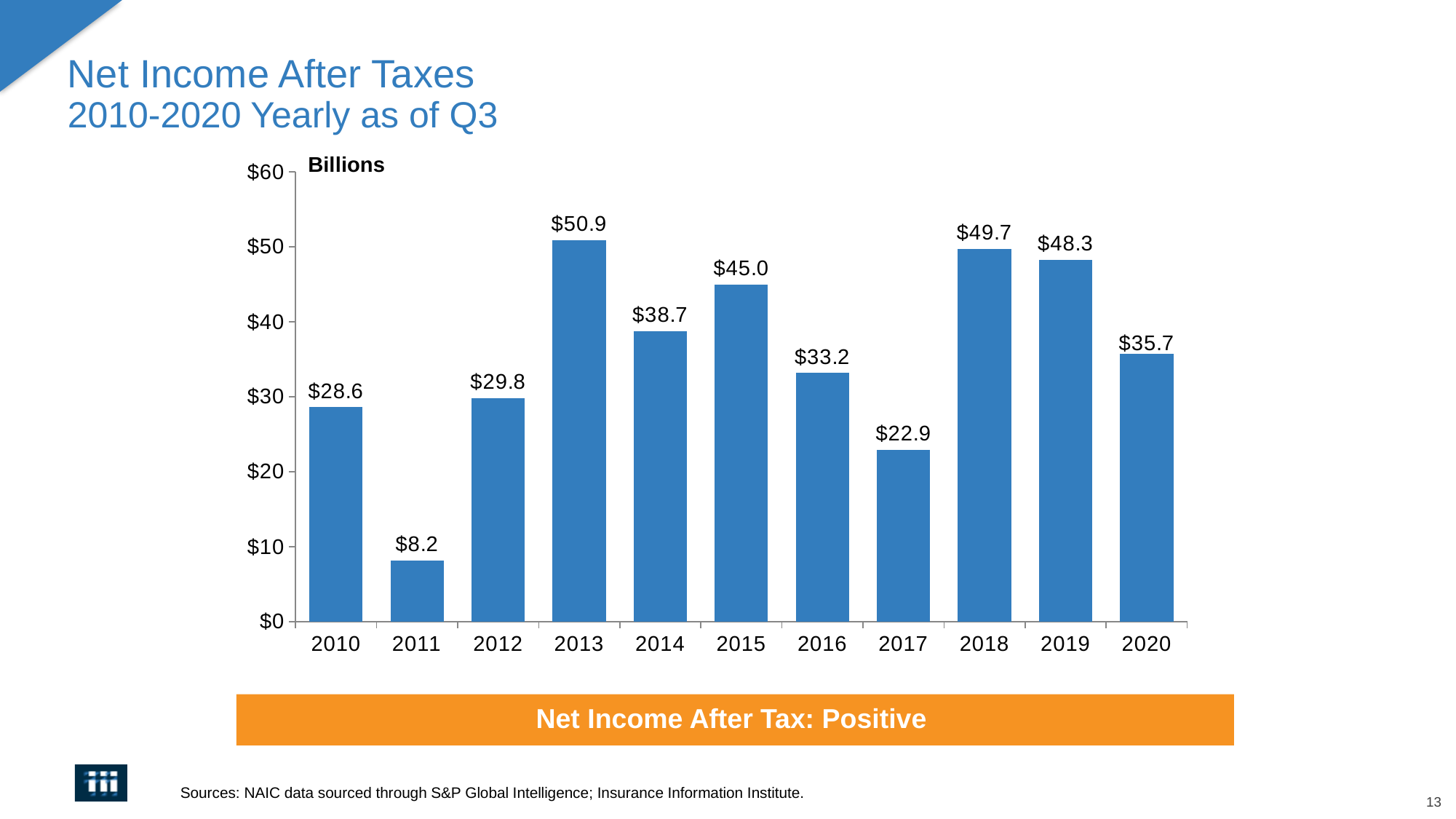
How many years are shown on the x axis of the chart? 11 What is the net income after taxes for 2011? $8.2 Did net income after taxes rise or fall from 2019 to 2020? Fall Which year has the highest net income after taxes? 2013 What is the net income after taxes for 2020? $35.7 Which year has a larger net income after taxes, 2015 or 2016? 2015 What is the difference between the net income after taxes in 2018 and 2017? $26.8 Which year has the lowest net income after taxes? 2011 Is the value for 2014 greater or less than $40? less What is the net income after taxes for 2013? $50.9 What kind of chart is shown on the slide? Bar chart What unit is indicated at the top of the y axis? Billions